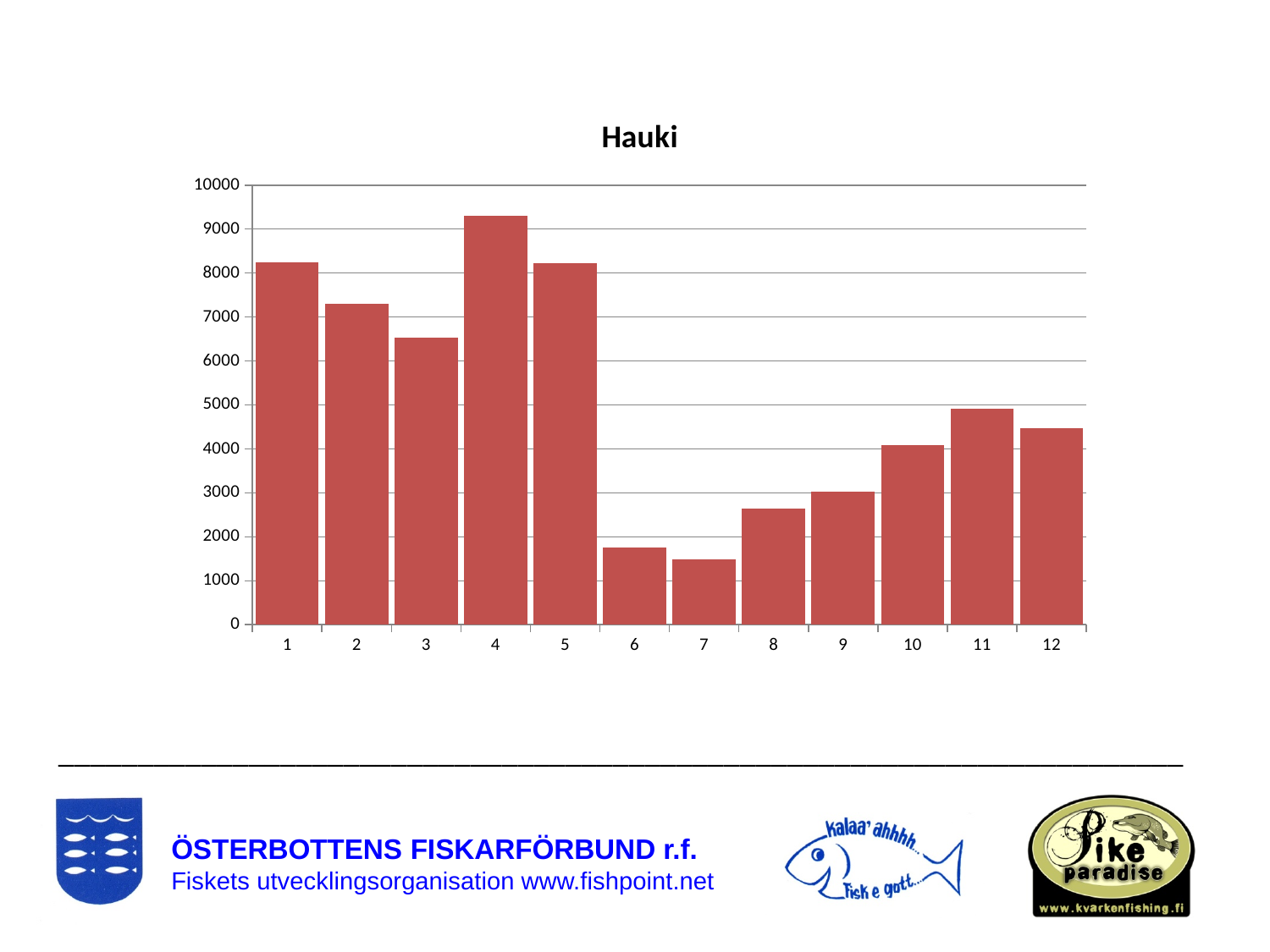
What kind of chart is shown on the slide? bar chart Is the value for category 4 greater or less than 9000? greater How many categories are shown on the x axis of the chart? 12 Is the value for category 3 greater or less than 6000? greater Is the value for category 8 greater or less than 3000? less Which has the larger value, category 2 or category 3? 2 Which has the larger value, category 11 or category 12? 11 What is the title of the chart? Hauki Which category has the lowest value in the chart? 7 Which category has the highest value in the chart? 4 Do the values rise or fall from category 7 to category 11? rise